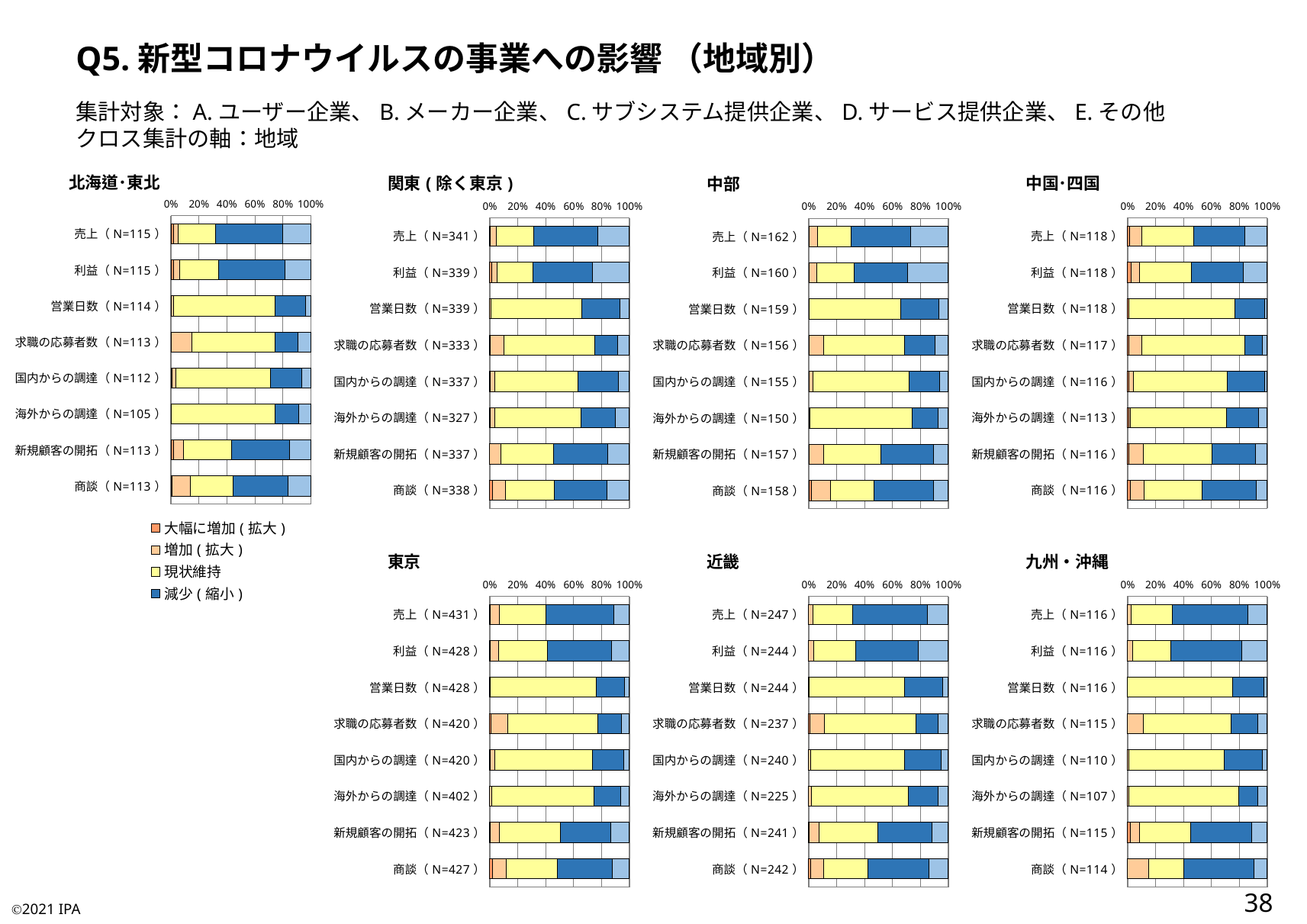
How many series does the legend list? 4 What kind of chart is used for the 北海道・東北 panel? Stacked bar chart What is the difference between the N value for 売上 in the 東京 chart and the N value for 売上 in the 北海道・東北 chart? 316 In the 関東(除く東京) chart, which category has the largest N value? 売上 (N=341) How many separate regional charts are shown on the slide? 7 In the 東京 chart, is the 現状維持 share for 営業日数 greater or less than 60%? greater Which colour represents 現状維持 in the legend? Yellow How many categories are plotted in the 東京 chart? 8 In the 北海道・東北 chart, which has the larger 現状維持 share: 営業日数 or 売上? 営業日数 In the 東京 chart, what is the N value shown for 売上? N=431 In the 北海道・東北 chart, what is the N value shown for 海外からの調達? N=105 In the 近畿 chart, which category has the smallest N value? 海外からの調達 (N=225)